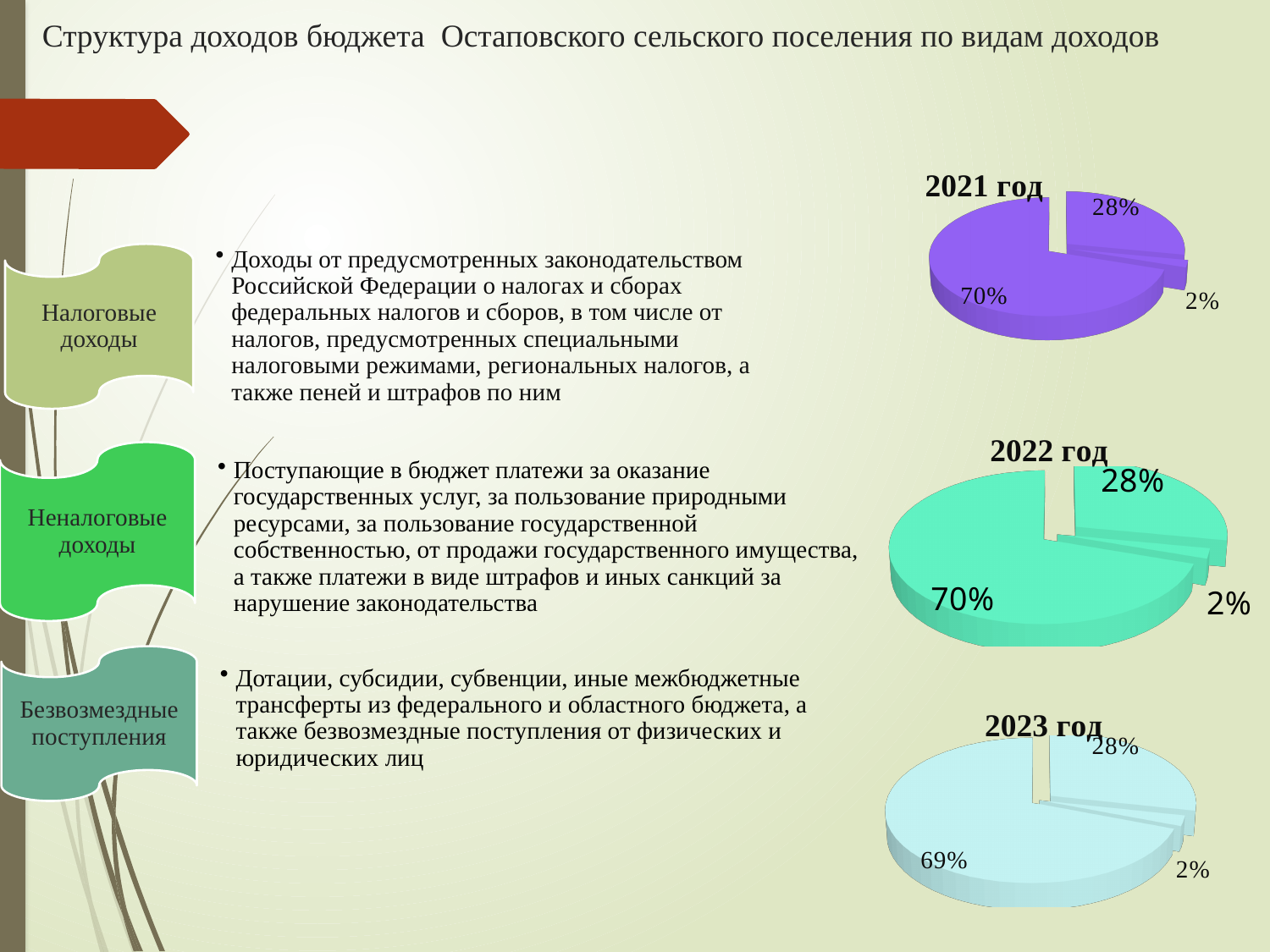
What is the title of the bottom pie chart on the slide? 2023 год What type of chart is used for the 2021 год chart? pie chart In the 2023 год pie chart, what is the difference between the largest slice and the second-largest slice? 41% In the 2023 год pie chart, what is the share of the largest slice? 69% Which is larger: the largest slice in the 2022 год chart or the largest slice in the 2023 год chart? 2022 год In the 2021 год pie chart, what is the share of the largest slice? 70% How many pie charts are shown on the slide? 3 In the 2022 год pie chart, what is the share of the largest slice? 70% How many slices does the 2022 год pie chart have? 3 In the 2021 год pie chart, what is the difference between the largest slice and the smallest slice? 68% In the 2021 год pie chart, what is the share of the smallest slice? 2% In the 2023 год pie chart, what is the share of the smallest slice? 2%